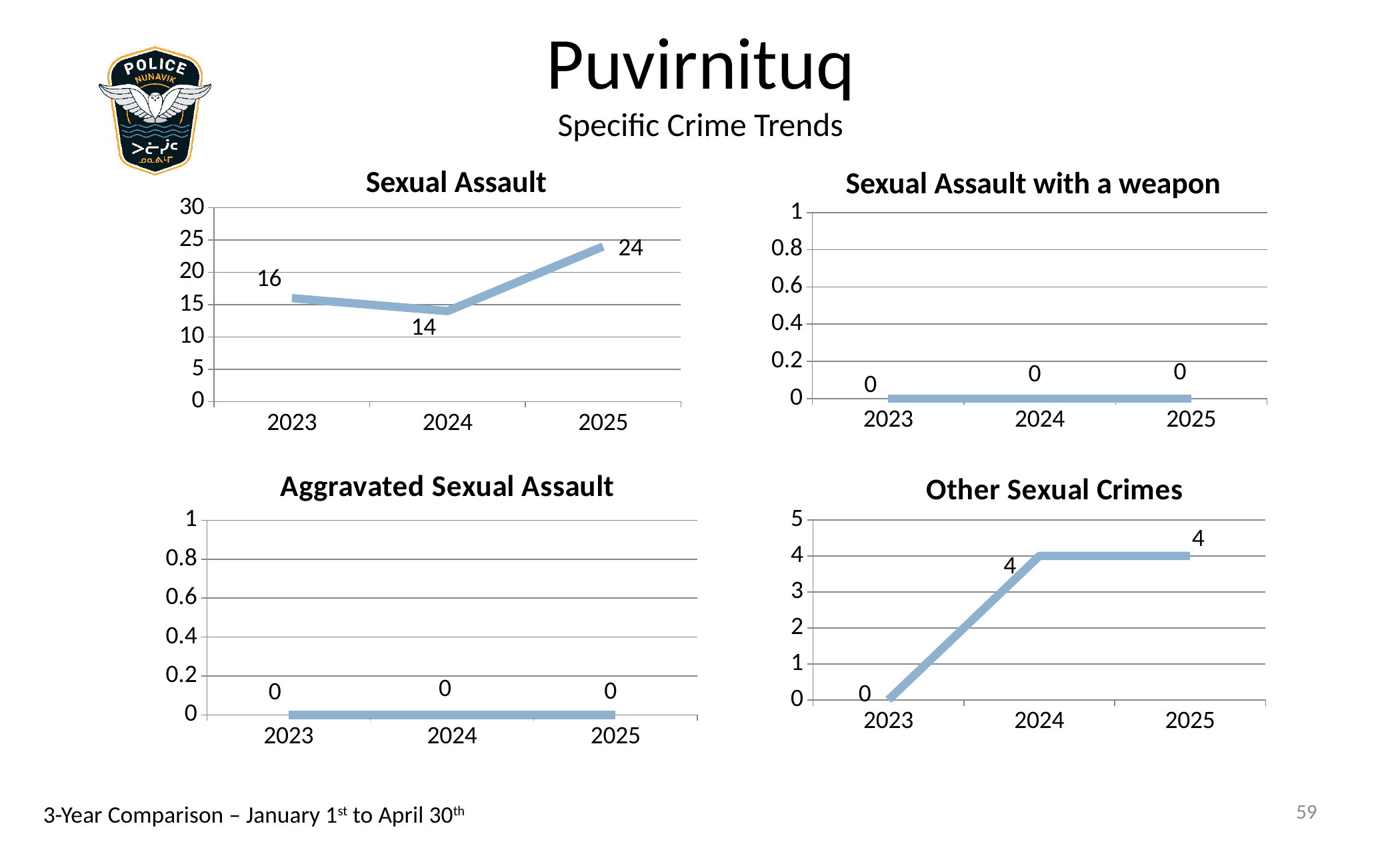
In the 'Sexual Assault' chart, what is the value for 2025? 24 What kind of chart is the 'Other Sexual Crimes' chart? line chart In the 'Other Sexual Crimes' chart, do the values rise or fall from 2023 to 2024? rise In the 'Sexual Assault' chart, what is the difference between the 2025 and 2023 values? 8 In the 'Other Sexual Crimes' chart, which is larger, the value for 2024 or the value for 2023? 2024 In the 'Sexual Assault' chart, which year has the lowest value? 2024 In the 'Aggravated Sexual Assault' chart, how many years are plotted? 3 In the 'Sexual Assault with a weapon' chart, what is the value for 2024? 0 In the 'Other Sexual Crimes' chart, what is the value for 2023? 0 In the 'Sexual Assault' chart, what is the value for 2024? 14 In the 'Sexual Assault' chart, which year has the highest value? 2025 In the 'Sexual Assault' chart, is the value for 2023 greater or less than 15? greater